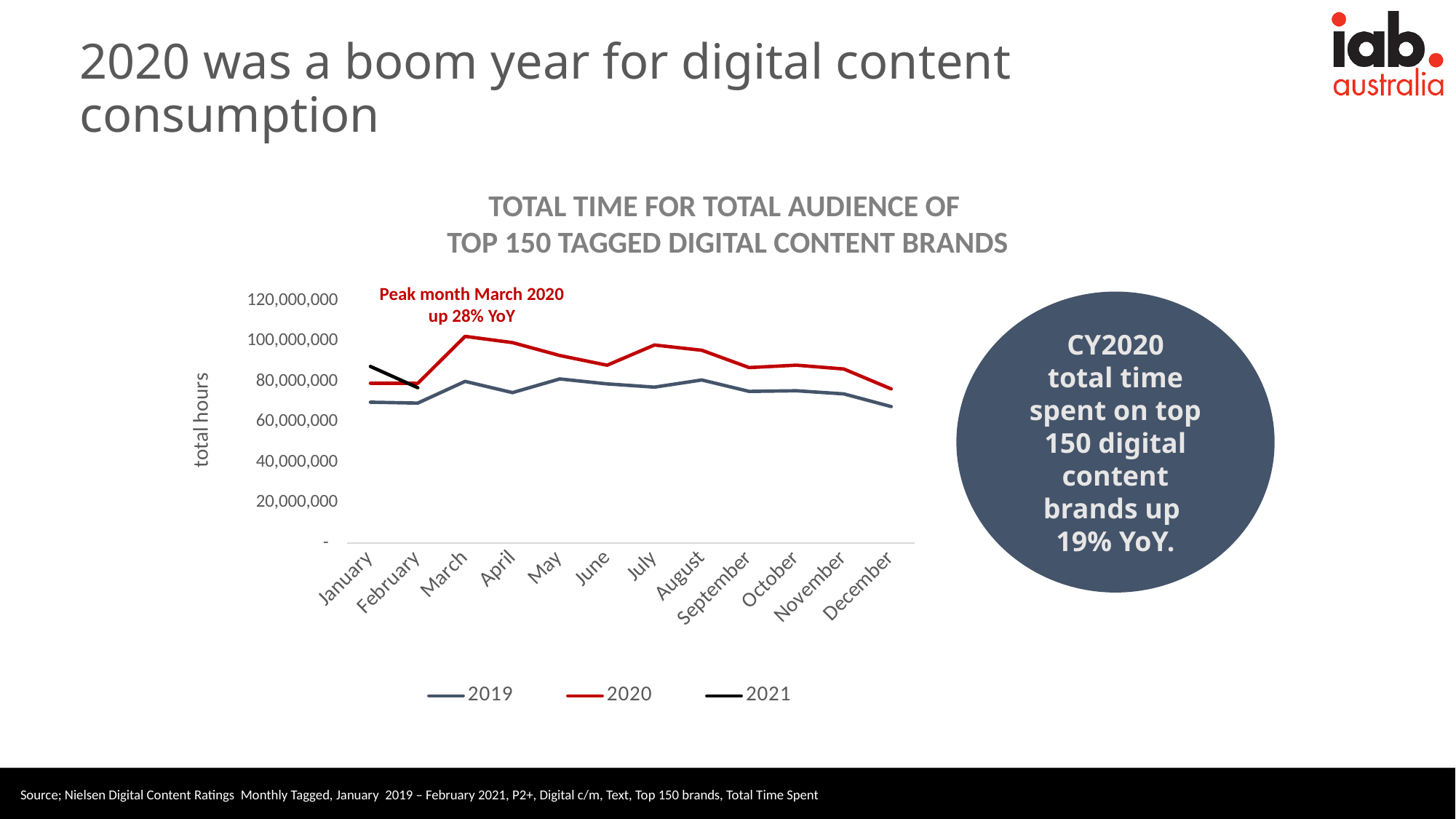
Is the value for 2021 in January greater or less than 80,000,000? greater How many months are shown along the x axis? 12 In July, which series has the larger value, 2019 or 2020? 2020 In January, which series has the larger value, 2019 or 2021? 2021 What is the label on the y axis? total hours Is the value for 2020 in March greater or less than 80,000,000? greater Does the 2020 series rise or fall from March to June? Fall What kind of chart is shown on the slide? Line chart How many series does the legend list? 3 Is the value for 2019 in January greater or less than 80,000,000? less Which month was the peak month for the 2020 series? March